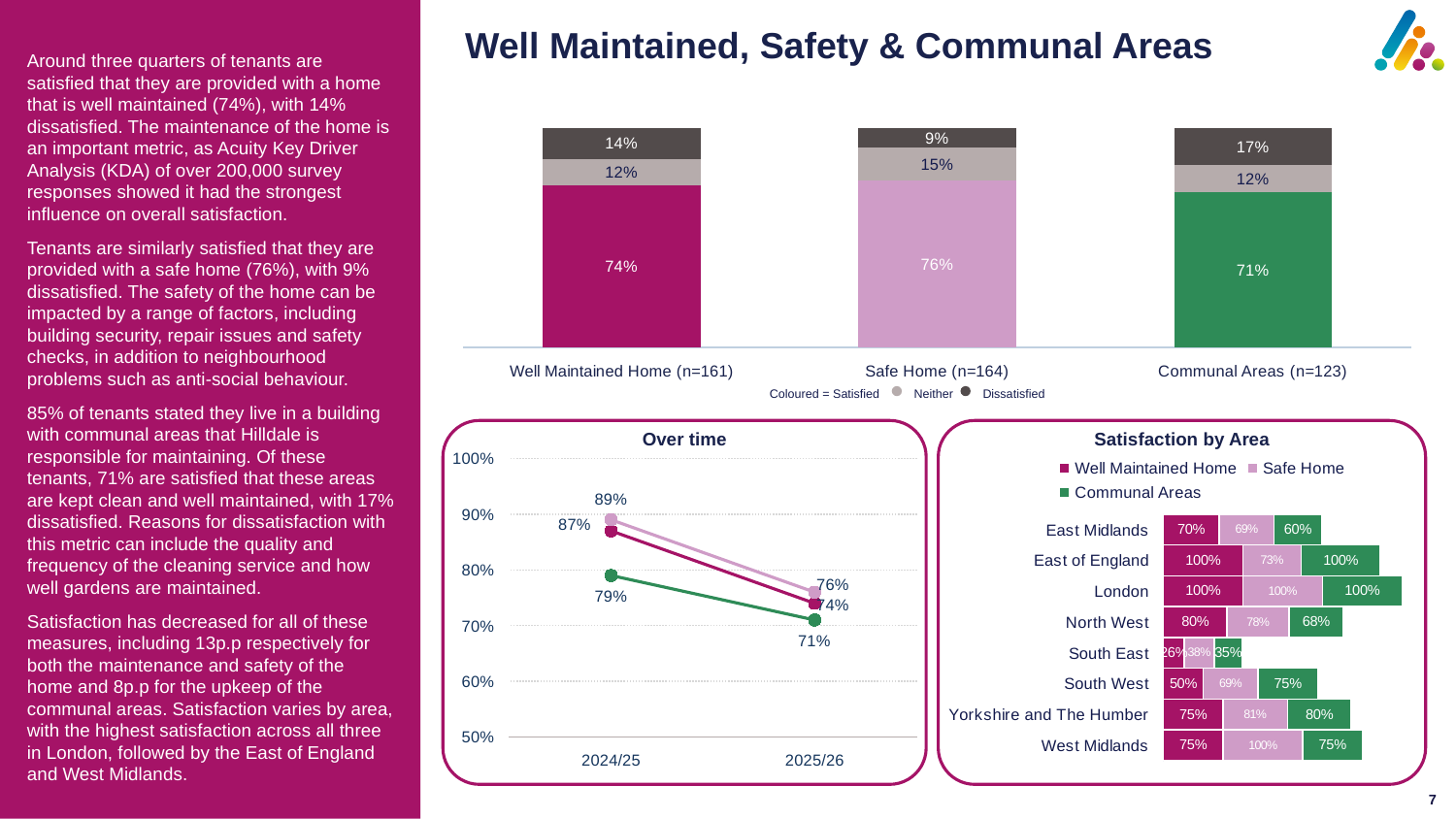
In the 'Over time' chart, what was the Communal Areas satisfaction in 2024/25? 79% In the 'Over time' chart, does Well Maintained Home satisfaction rise or fall from 2024/25 to 2025/26? Fall In the 'Over time' chart, by how many percentage points did Safe Home satisfaction change between 2024/25 and 2025/26? 13 percentage points In the top stacked bar chart, how many percentage points higher is the dissatisfied share for Communal Areas than for Safe Home? 8 percentage points In the top stacked bar chart, what percentage of tenants are satisfied with their Safe Home? 76% In the top stacked bar chart, which measure has the highest satisfied percentage? Safe Home What kind of chart is the 'Over time' chart? Line chart In the top stacked bar chart, what is the total of the three segments for Well Maintained Home? 100% How many series does the legend of the 'Satisfaction by Area' chart list? 3 In the 'Satisfaction by Area' chart, what is the Safe Home satisfaction for Yorkshire and The Humber? 81% In the top stacked bar chart, what percentage of tenants are dissatisfied with Communal Areas? 17% In the 'Satisfaction by Area' chart, which area has the lowest Well Maintained Home satisfaction? South East